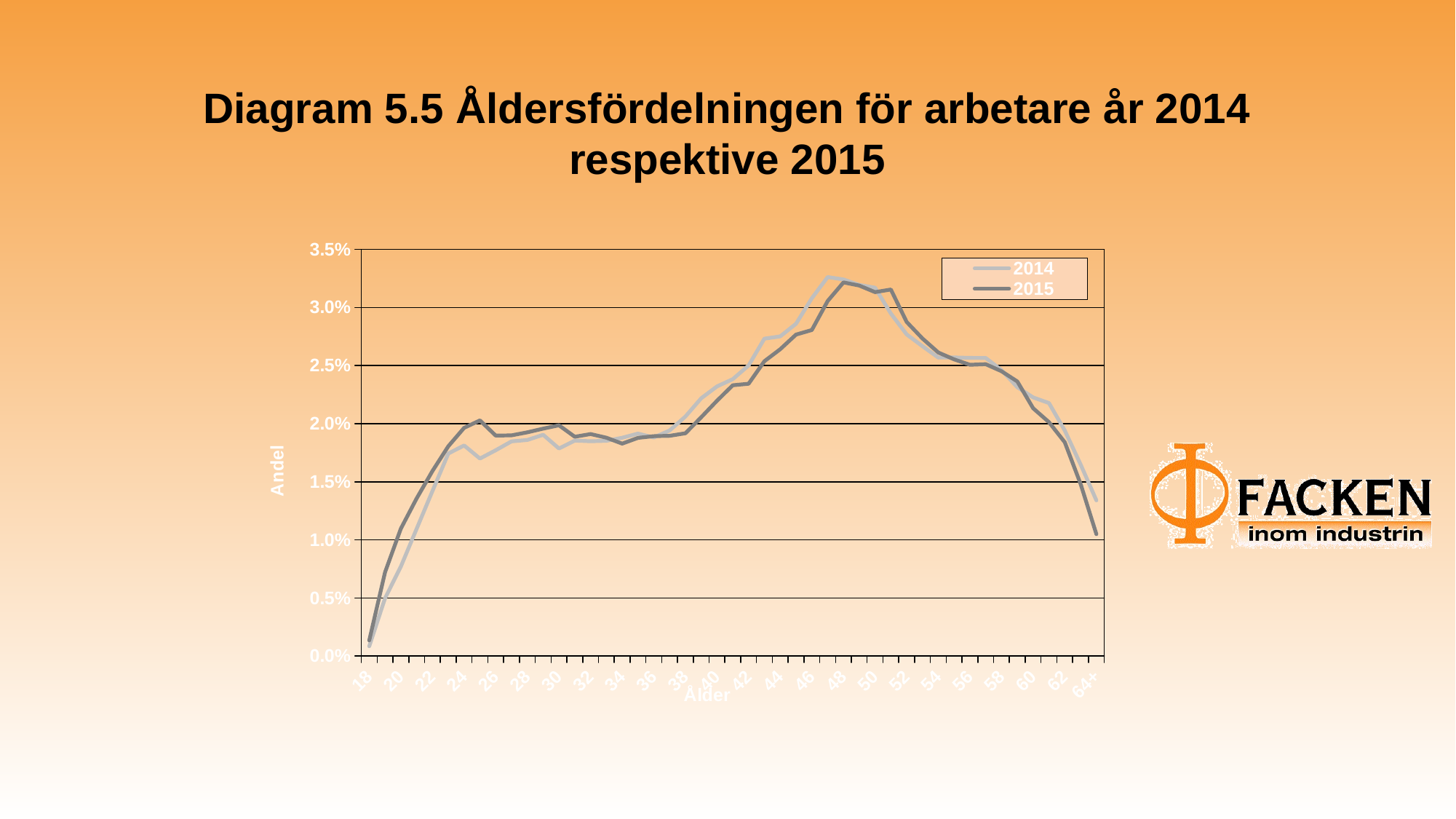
Is the value for 2015 at age 48 greater or less than 3.0%? greater At which age is the value for 2015 lowest? 18 Is the value for 2015 at age 64+ greater or less than 1.5%? less Do the values for 2014 rise or fall between age 50 and age 64+? fall What is the title of the vertical axis? Andel What kind of chart is shown on the slide? Line chart At age 64+, which series has the larger value, 2014 or 2015? 2014 What are the two series named in the legend? 2014 and 2015 Is the value for 2014 at age 40 greater or less than 2.0%? greater How many series does the legend list? 2